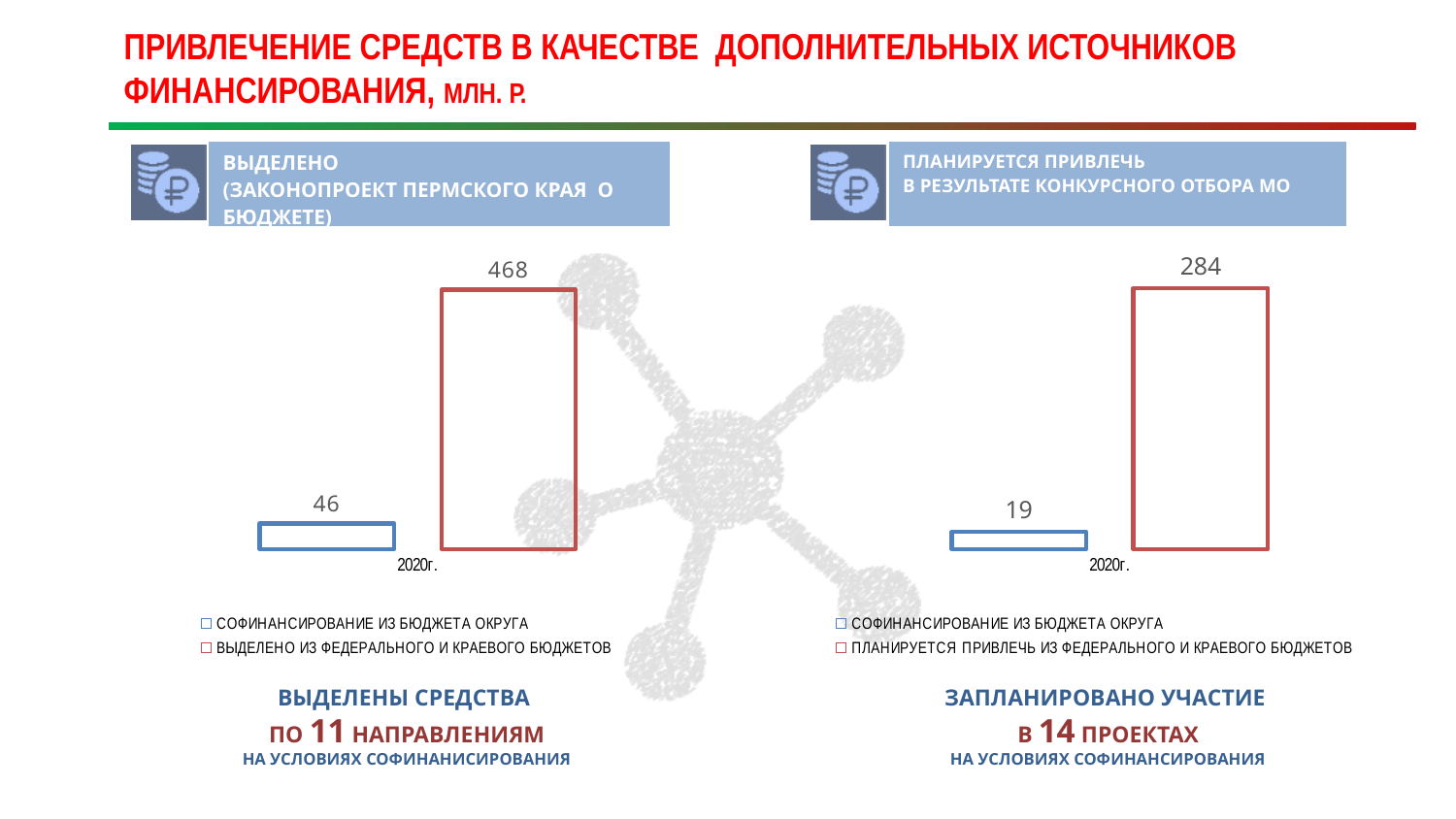
On the right chart, what is the difference between the two plotted values? 265 How many series does the legend of the right chart list? 2 On the left chart, what is the value for 'СОФИНАНСИРОВАНИЕ ИЗ БЮДЖЕТА ОКРУГА' in 2020г.? 46 Which is larger: the federal and regional budget value on the left chart (468) or on the right chart (284)? Left chart (468) On the right chart, what is the value for 'ПЛАНИРУЕТСЯ ПРИВЛЕЧЬ ИЗ ФЕДЕРАЛЬНОГО И КРАЕВОГО БЮДЖЕТОВ' in 2020г.? 284 On the right chart, what is the value for 'СОФИНАНСИРОВАНИЕ ИЗ БЮДЖЕТА ОКРУГА' in 2020г.? 19 What is the x-axis category label shown on both charts? 2020г. What type of chart is the left chart? Bar chart On the left chart, what is the difference between the two plotted values? 422 On the right chart, which series has the lower value? СОФИНАНСИРОВАНИЕ ИЗ БЮДЖЕТА ОКРУГА On the left chart, what is the value for 'ВЫДЕЛЕНО ИЗ ФЕДЕРАЛЬНОГО И КРАЕВОГО БЮДЖЕТОВ' in 2020г.? 468 On the left chart, which series has the higher value? ВЫДЕЛЕНО ИЗ ФЕДЕРАЛЬНОГО И КРАЕВОГО БЮДЖЕТОВ